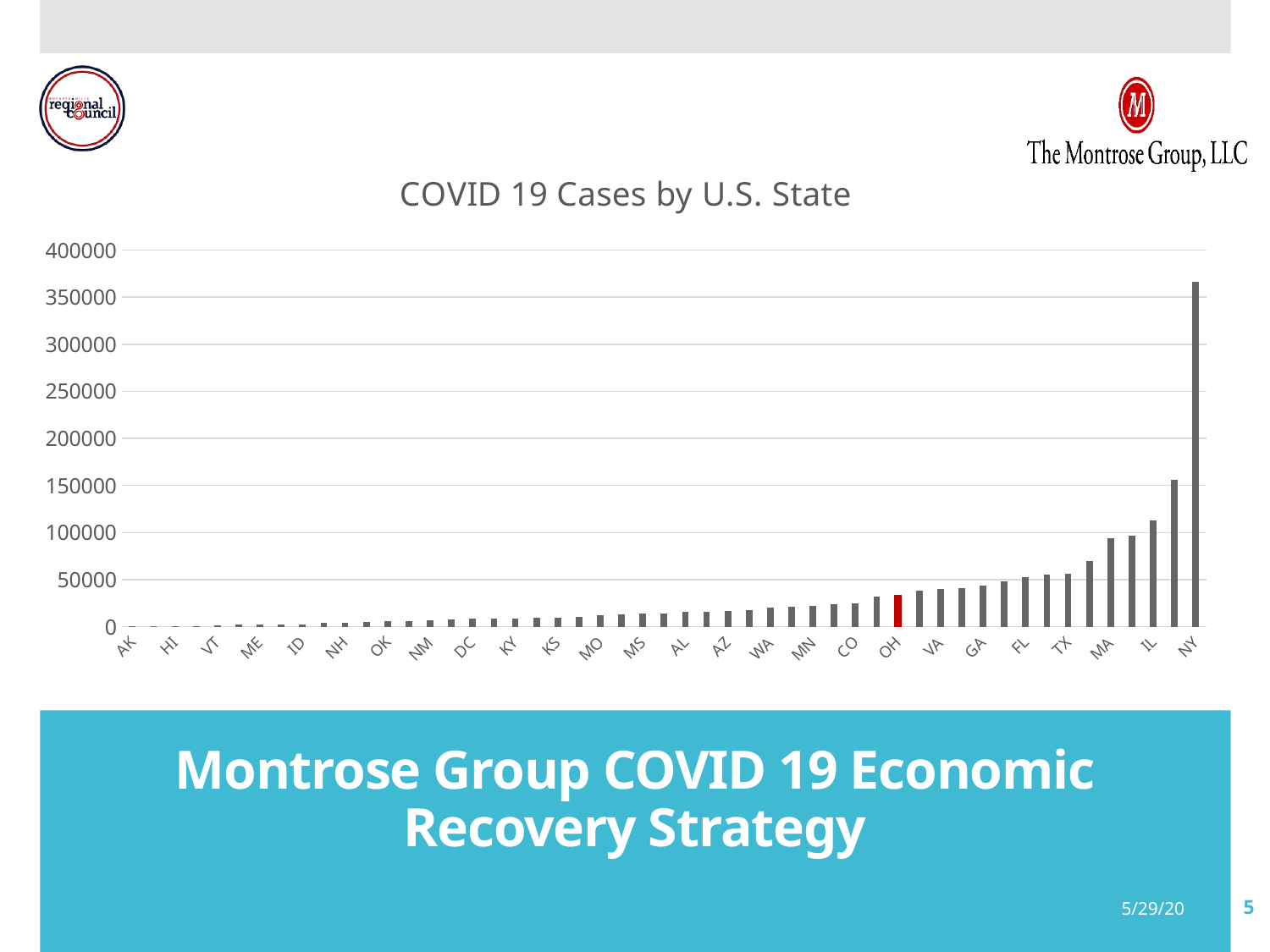
Which state has the highest number of COVID 19 cases in the chart? NY Which has more COVID 19 cases, NY or IL? NY What type of chart is shown on the slide? bar chart Is the value for MA greater or less than 150000? less Is the value for GA greater or less than 50000? less Do the values rise or fall moving from left to right along the x axis? rise Which has more COVID 19 cases, MA or OH? MA Is the value for NY greater or less than 300000? greater What is the title of the chart? COVID 19 Cases by U.S. State Which state's bar is highlighted in red? OH